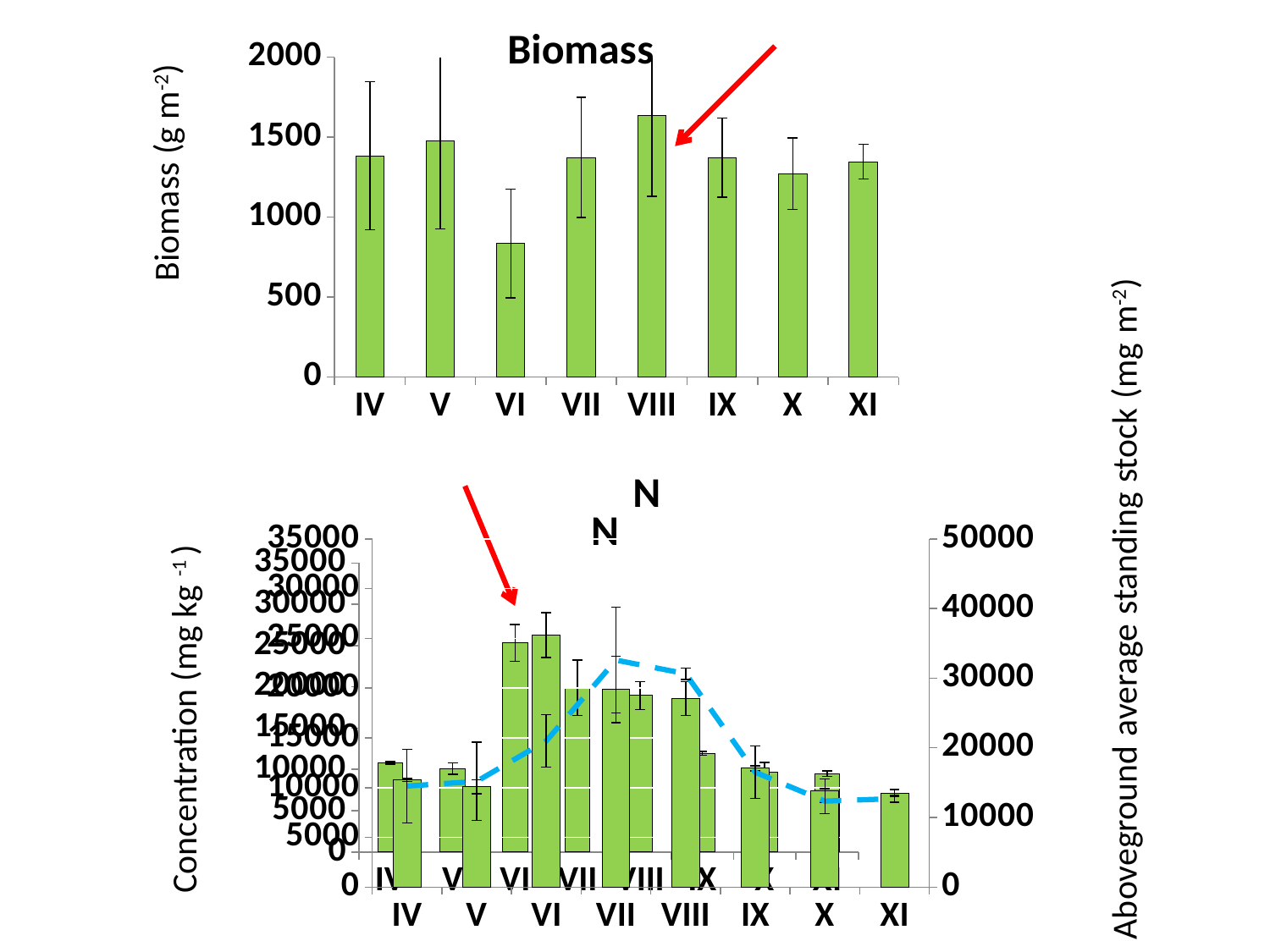
In the Biomass chart, which is larger, the value for VIII or the value for X? VIII What is the y-axis label of the Biomass chart? Biomass (g m-2) In the Biomass chart, which is larger, the value for V or the value for VI? V How many categories are shown on the x axis of the Biomass chart? 8 In the Biomass chart, is the value for VI greater or less than 1000? less In the Biomass chart, which category has the highest biomass? VIII In the Biomass chart, which category has the lowest biomass? VI How many categories are shown on the x axis of the bottom chart? 8 What is the label of the right-hand y axis on the bottom chart? Aboveground average standing stock (mg m-2) What type of chart is the Biomass chart? bar chart In the Biomass chart, is the value for X greater or less than 1500? less In the Biomass chart, is the value for VIII greater or less than 1500? greater